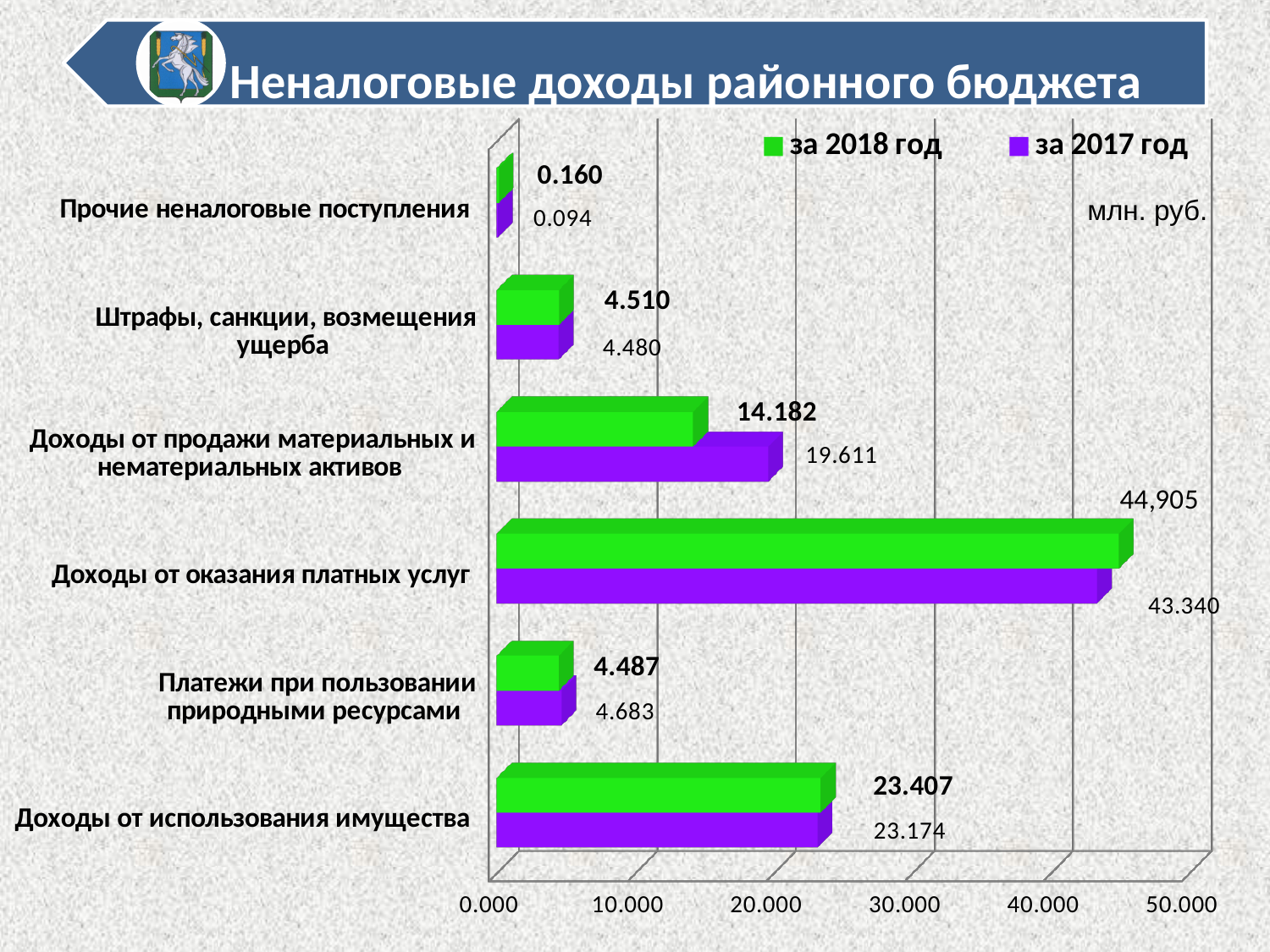
What is the value for 'Платежи при пользовании природными ресурсами' for 'за 2017 год'? 4.683 What unit is indicated on the chart? млн. руб. What is the value for 'Доходы от оказания платных услуг' for 'за 2018 год'? 44,905 Which category has the lowest value for 'за 2018 год'? Прочие неналоговые поступления How many categories are shown on the chart? 6 How many series does the legend list? 2 What type of chart is shown on the slide? bar chart What is the difference between the 'за 2017 год' and 'за 2018 год' values for 'Доходы от продажи материальных и нематериальных активов'? 5.429 What is the value for 'Доходы от продажи материальных и нематериальных активов' for 'за 2017 год'? 19.611 For 'Доходы от использования имущества', which series has the larger value: 'за 2018 год' or 'за 2017 год'? за 2018 год Which category has the highest value for 'за 2017 год'? Доходы от оказания платных услуг What is the value for 'Прочие неналоговые поступления' for 'за 2018 год'? 0.160